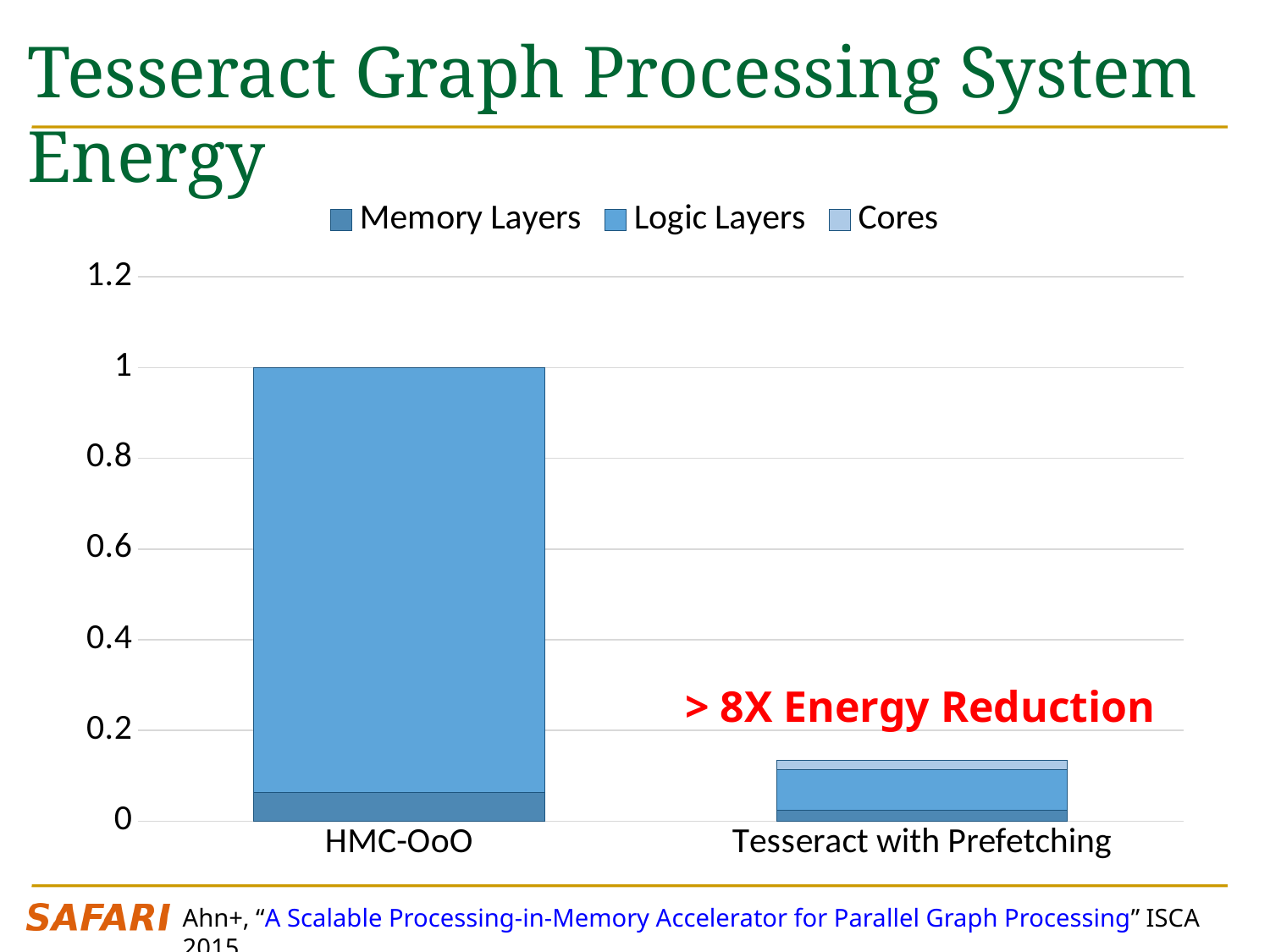
Is the total value for Tesseract with Prefetching greater or less than 0.2? less Which category has the lowest total energy? Tesseract with Prefetching Is the Memory Layers value for HMC-OoO greater or less than 0.2? less How many categories are shown on the x axis? 2 Which has a larger total bar, HMC-OoO or Tesseract with Prefetching? HMC-OoO Which category has the highest total energy? HMC-OoO What kind of chart is shown on the slide? bar chart Do the total bar values rise or fall from left to right along the x axis? fall How many series does the legend list? 3 What does the red annotation on the chart say? > 8X Energy Reduction What is the total height of the stacked bar for HMC-OoO? 1 What are the three series listed in the legend? Memory Layers, Logic Layers, Cores